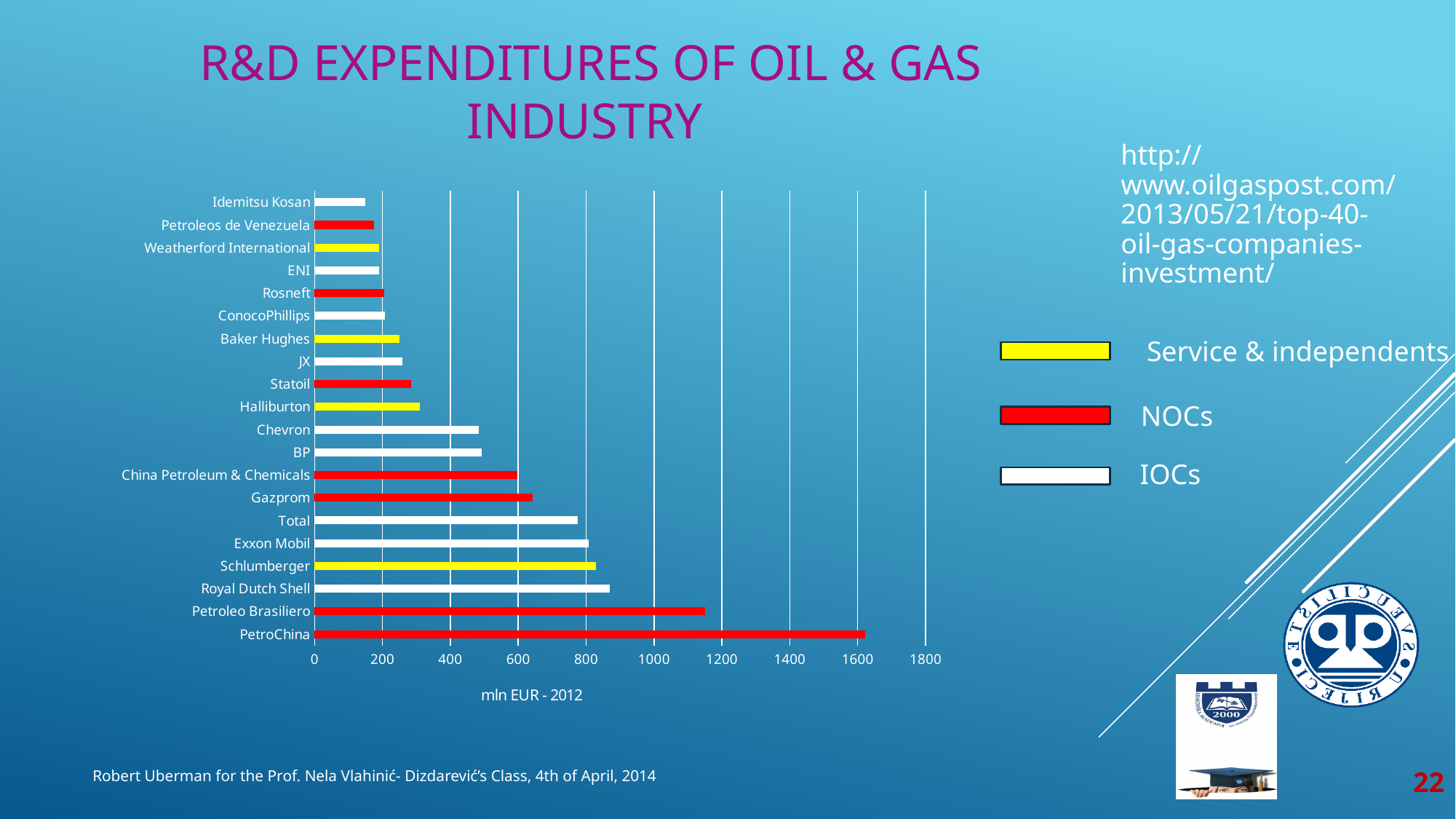
Which company has the highest R&D expenditure in the chart? PetroChina Which has a larger R&D expenditure, Chevron or Halliburton? Chevron What unit is shown on the horizontal axis label of the chart? mln EUR - 2012 How many companies are plotted in the chart? 20 What kind of chart is shown on the slide? bar chart Is the value for Halliburton greater or less than 200? greater Is the value for Total greater or less than 800? less Is the value for BP greater or less than 600? less Which company has the lowest R&D expenditure in the chart? Idemitsu Kosan Which has a larger R&D expenditure, Petroleo Brasiliero or Royal Dutch Shell? Petroleo Brasiliero